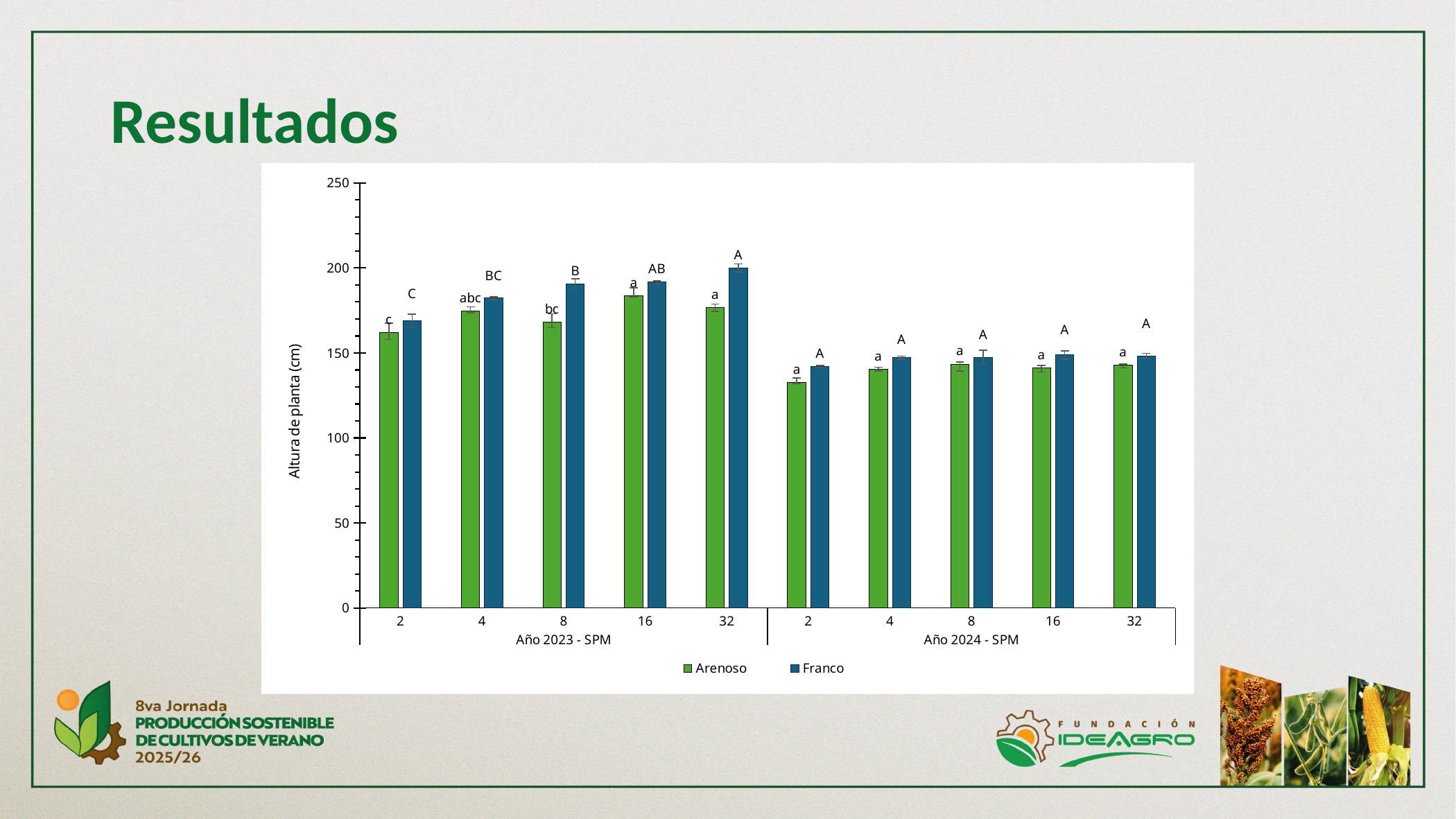
Is the value for Franco at 32 in Año 2023 - SPM greater or less than 150? greater At category 8 in Año 2023 - SPM, which series has the taller bar, Arenoso or Franco? Franco Which is taller: the Arenoso bar at 16 in Año 2023 - SPM or the Arenoso bar at 16 in Año 2024 - SPM? Año 2023 - SPM What letter label appears above the Franco bar at category 2 in Año 2023 - SPM? C What are the two series named in the legend? Arenoso and Franco How many category groups (bar pairs) are plotted along the x axis in total? 10 Which bar is the shortest in the chart? Arenoso at 2, Año 2024 - SPM Is the value for Arenoso at 2 in Año 2024 - SPM greater or less than 150? less Do the Franco bars rise or fall from category 2 to category 32 within Año 2023 - SPM? rise How many series does the legend list? 2 What type of chart is shown on the slide? Bar chart Which bar is the tallest in the chart? Franco at 32, Año 2023 - SPM